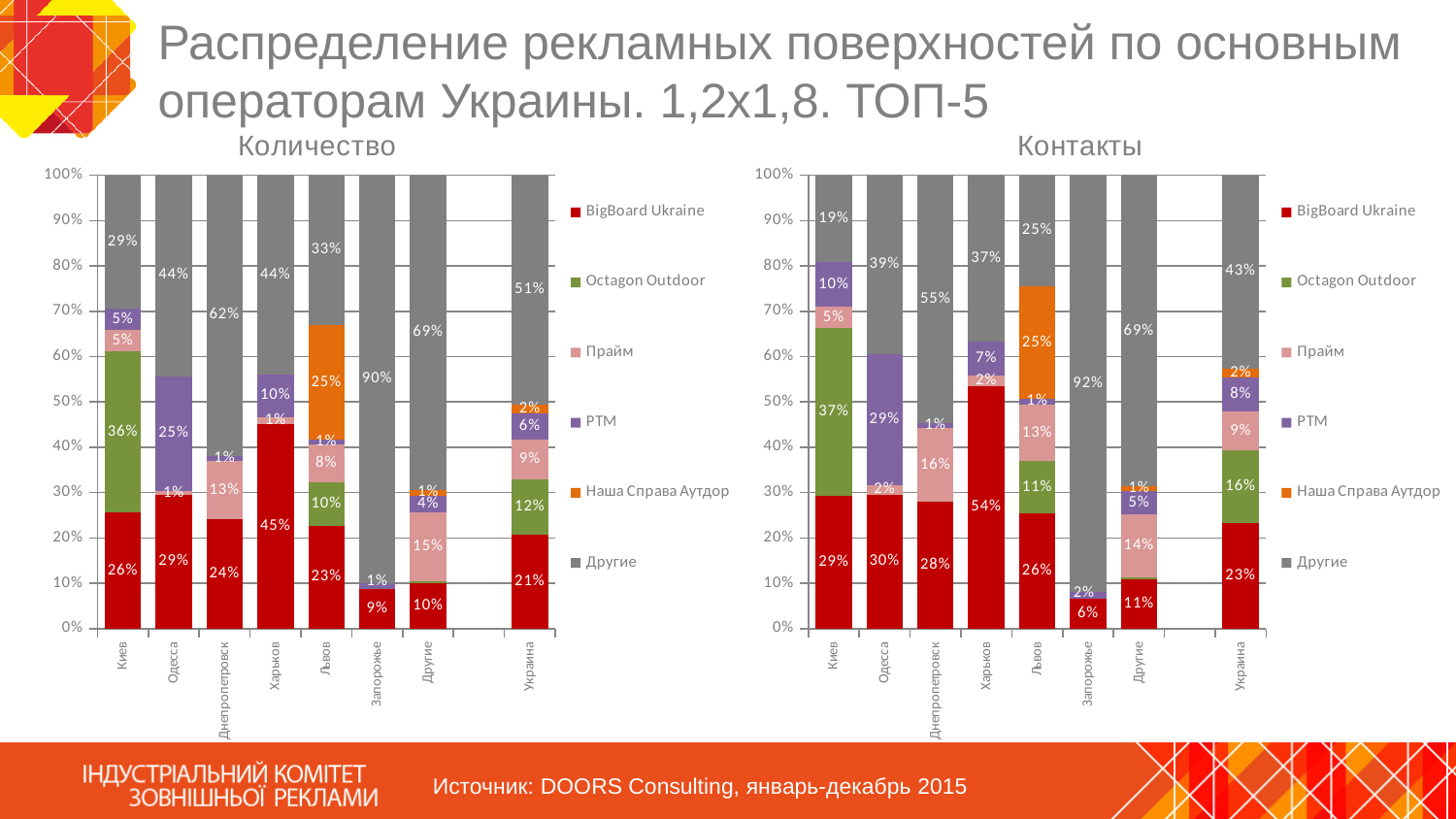
What type of chart is the "Количество" chart? Stacked bar chart How many categories are shown on the x axis of the "Количество" chart? 8 In the "Контакты" chart, which category has the lowest BigBoard Ukraine share? Запорожье In the "Количество" chart, which category has the highest BigBoard Ukraine share? Харьков In the "Количество" chart, what is the Octagon Outdoor share for Киев? 36% In the "Количество" chart, what is the BigBoard Ukraine share for Харьков? 45% In the "Контакты" chart, what is the Наша Справа Аутдор share for Львов? 25% In the "Контакты" chart, what is the Прайм share for Украина? 9% In the "Контакты" chart, what is the Другие share for Запорожье? 92% In the "Контакты" chart, which is larger for Киев: the Octagon Outdoor share or the Другие share? Octagon Outdoor In the "Количество" chart, what is the difference between the Другие share for Запорожье and for Украина? 39% How many series does the legend of the "Контакты" chart list? 6